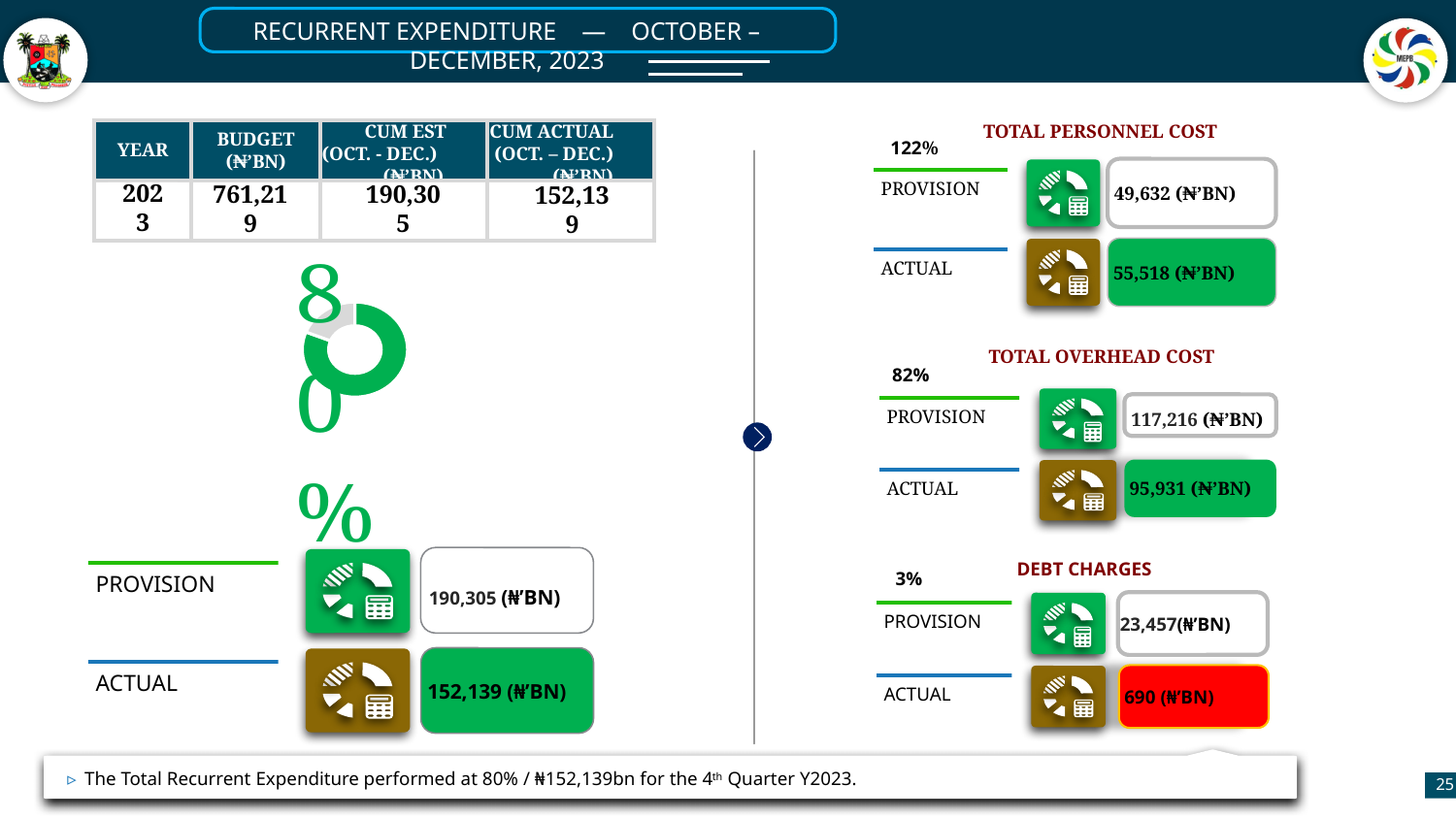
What is the PROVISION value shown below the doughnut chart? 190,305 (₦'BN) What type of chart is shown on the left side of the slide? doughnut chart Below the doughnut chart, which is larger, the PROVISION value or the ACTUAL value? PROVISION What colour is the filled portion of the doughnut chart? green How many categories (PROVISION and ACTUAL) are listed below the doughnut chart? 2 What is the title of the slide containing the doughnut chart? RECURRENT EXPENDITURE — OCTOBER – DECEMBER, 2023 What percentage is displayed in the centre of the doughnut chart? 80% What is the ACTUAL value shown below the doughnut chart? 152,139 (₦'BN) What is the difference between the PROVISION value (190,305) and the ACTUAL value (152,139) shown below the doughnut chart? 38,166